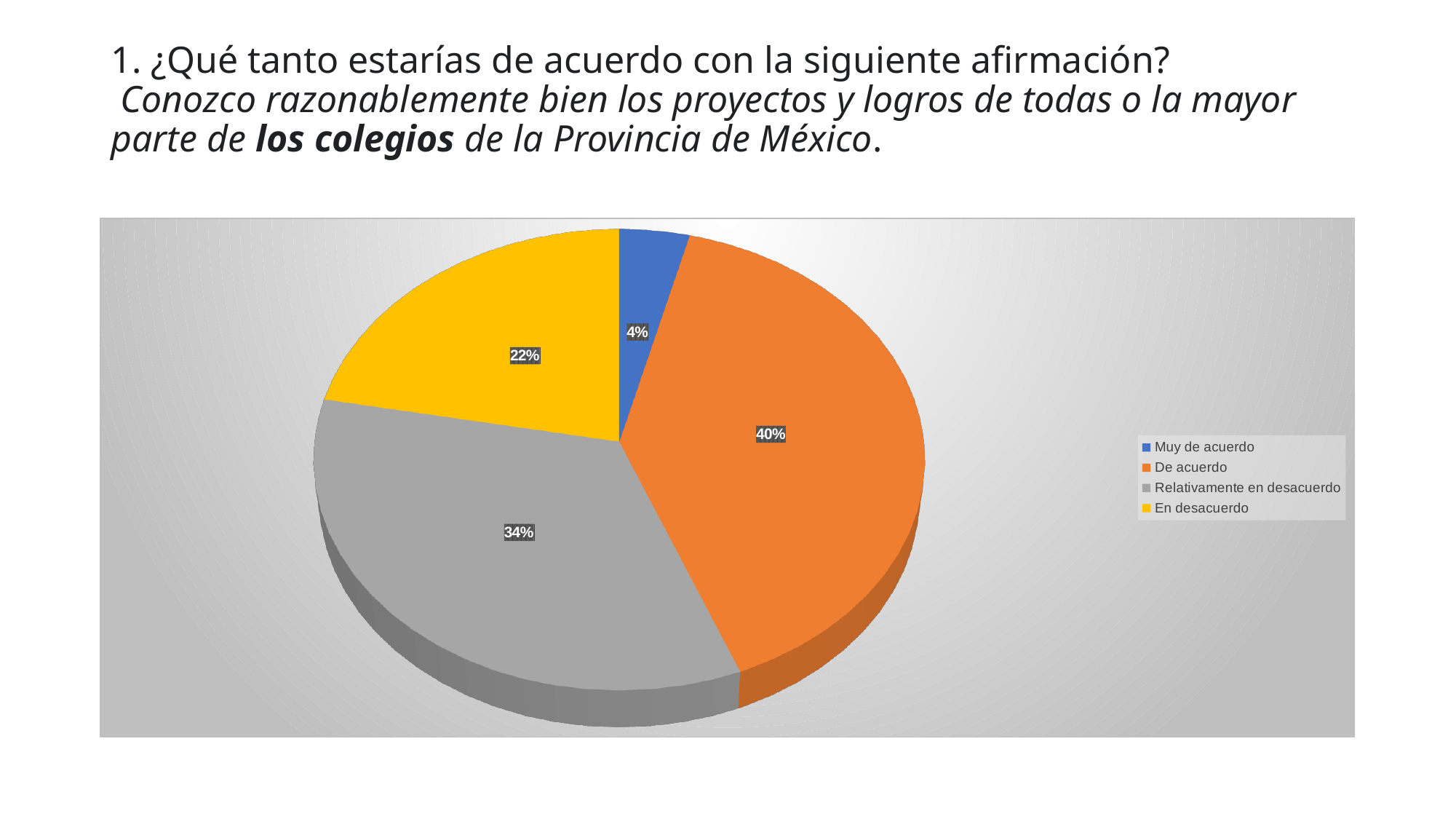
What is the difference in percentage points between "De acuerdo" and "Relativamente en desacuerdo"? 6 What percentage of respondents answered "En desacuerdo"? 22% What percentage of respondents answered "De acuerdo"? 40% How many categories does the pie chart have? 4 What kind of chart is shown on the slide? pie chart Which legend entry is shown in orange? De acuerdo What colour is the slice for "En desacuerdo"? yellow What percentage of respondents answered "Muy de acuerdo"? 4% Which is larger, the share for "En desacuerdo" or the share for "Relativamente en desacuerdo"? Relativamente en desacuerdo Which response category has the smallest share of the pie? Muy de acuerdo What percentage of respondents answered "Relativamente en desacuerdo"? 34% Which response category has the largest share of the pie? De acuerdo